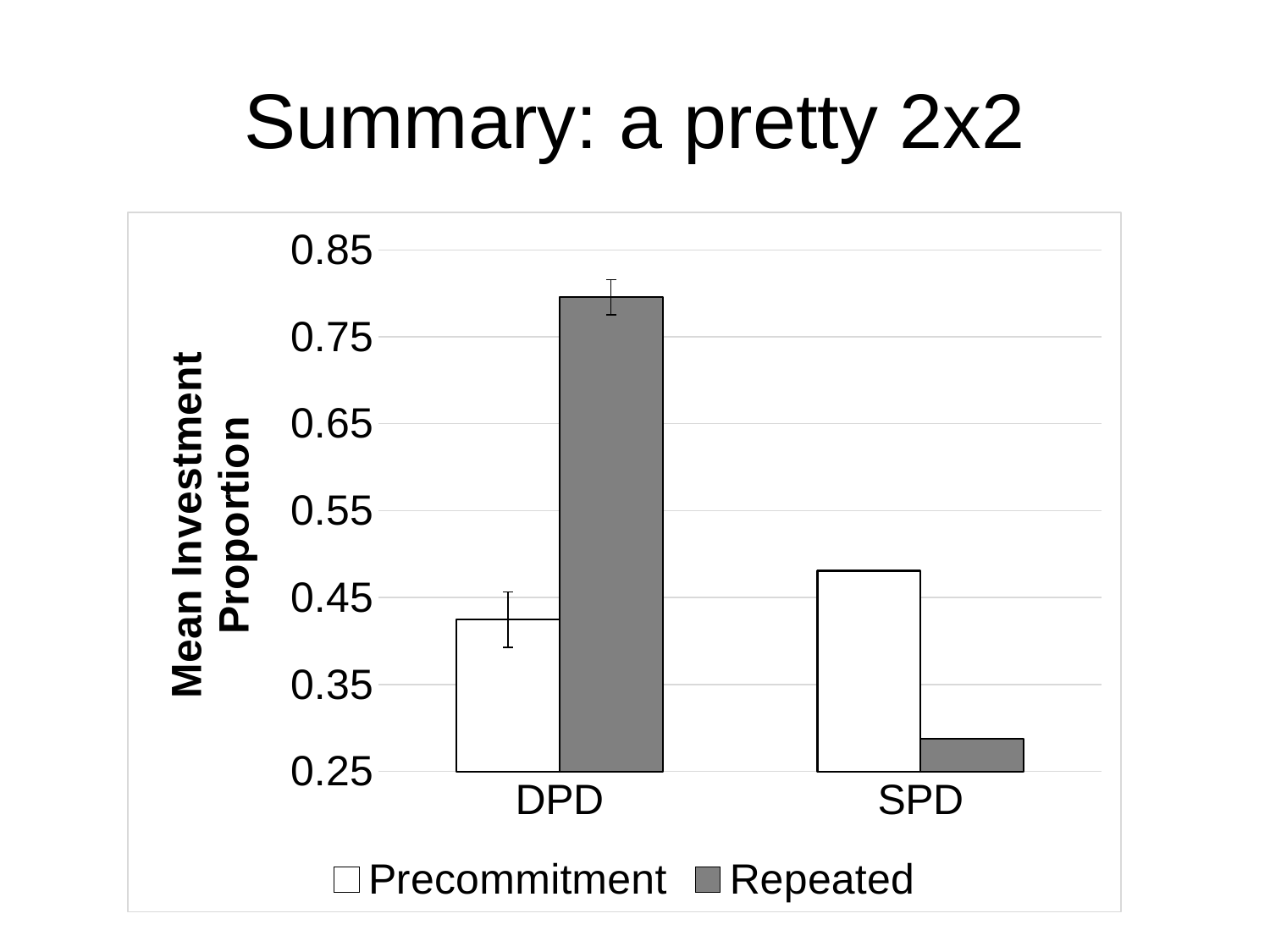
Is the Precommitment value for DPD greater or less than 0.55? less How many categories are shown on the x axis? 2 Which bar is the shortest in the chart? Repeated for SPD For SPD, which is larger: Precommitment or Repeated? Precommitment Is the Repeated value for SPD greater or less than 0.35? less What is the title of the y axis? Mean Investment Proportion What kind of chart is shown on the slide? bar chart Is the Repeated value for DPD greater or less than 0.75? greater For DPD, which is larger: Precommitment or Repeated? Repeated Which bar is the tallest in the chart? Repeated for DPD How many series does the legend list? 2